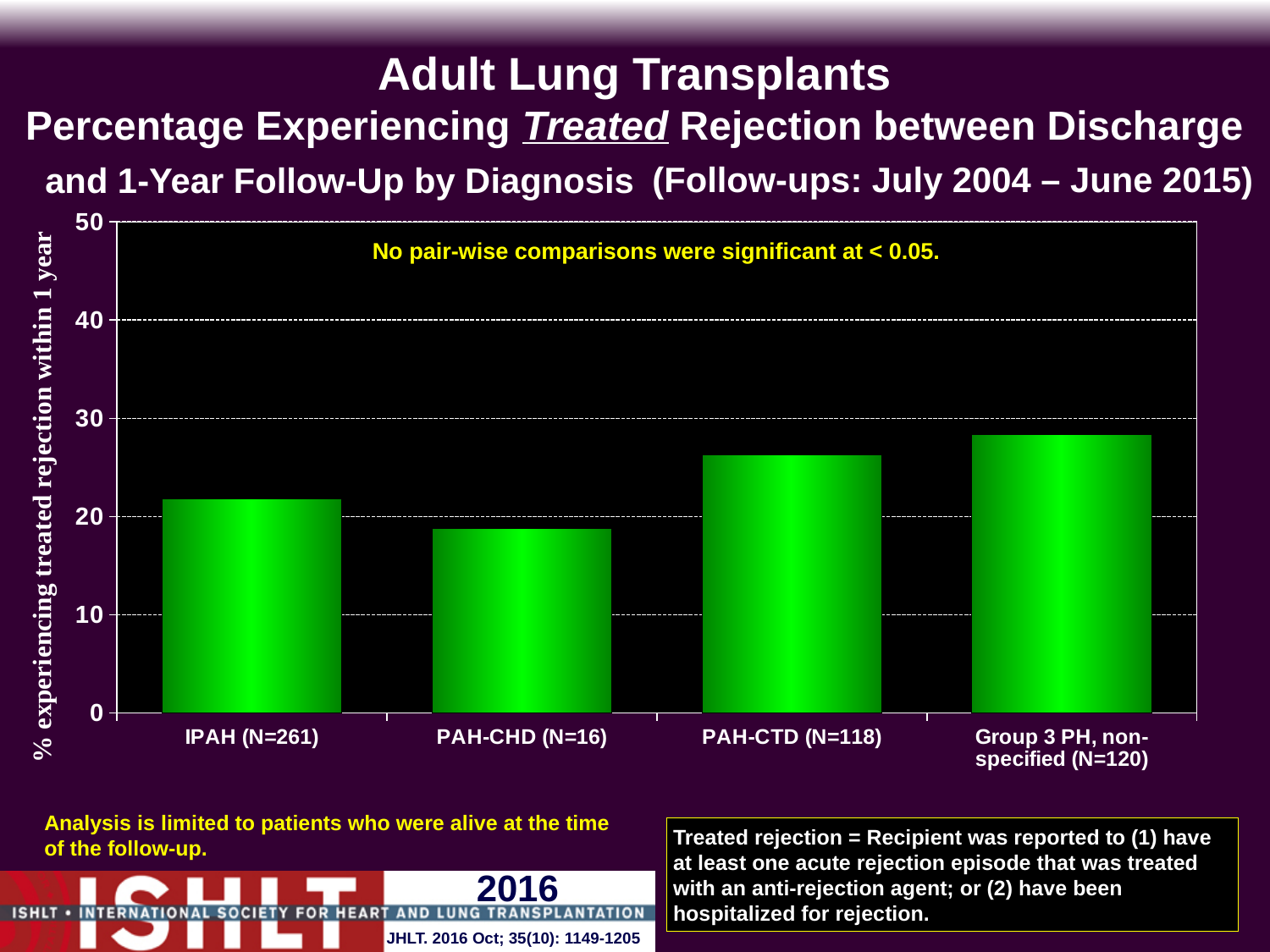
Is the value for IPAH (N=261) greater or less than 20? greater What kind of chart is shown on the slide? bar chart Is the value for PAH-CTD (N=118) greater or less than 30? less Which diagnosis group has the highest percentage experiencing treated rejection within 1 year? Group 3 PH, non-specified (N=120) Is the value for Group 3 PH, non-specified (N=120) greater or less than 30? less What is the label of the y axis? % experiencing treated rejection within 1 year How many diagnosis categories are plotted on the chart? 4 What is the maximum value shown on the y axis? 50 Which diagnosis group has the lowest percentage experiencing treated rejection within 1 year? PAH-CHD (N=16) Which is larger, the value for PAH-CHD (N=16) or the value for Group 3 PH, non-specified (N=120)? Group 3 PH, non-specified (N=120) Which is larger, the value for PAH-CTD (N=118) or the value for IPAH (N=261)? PAH-CTD (N=118)